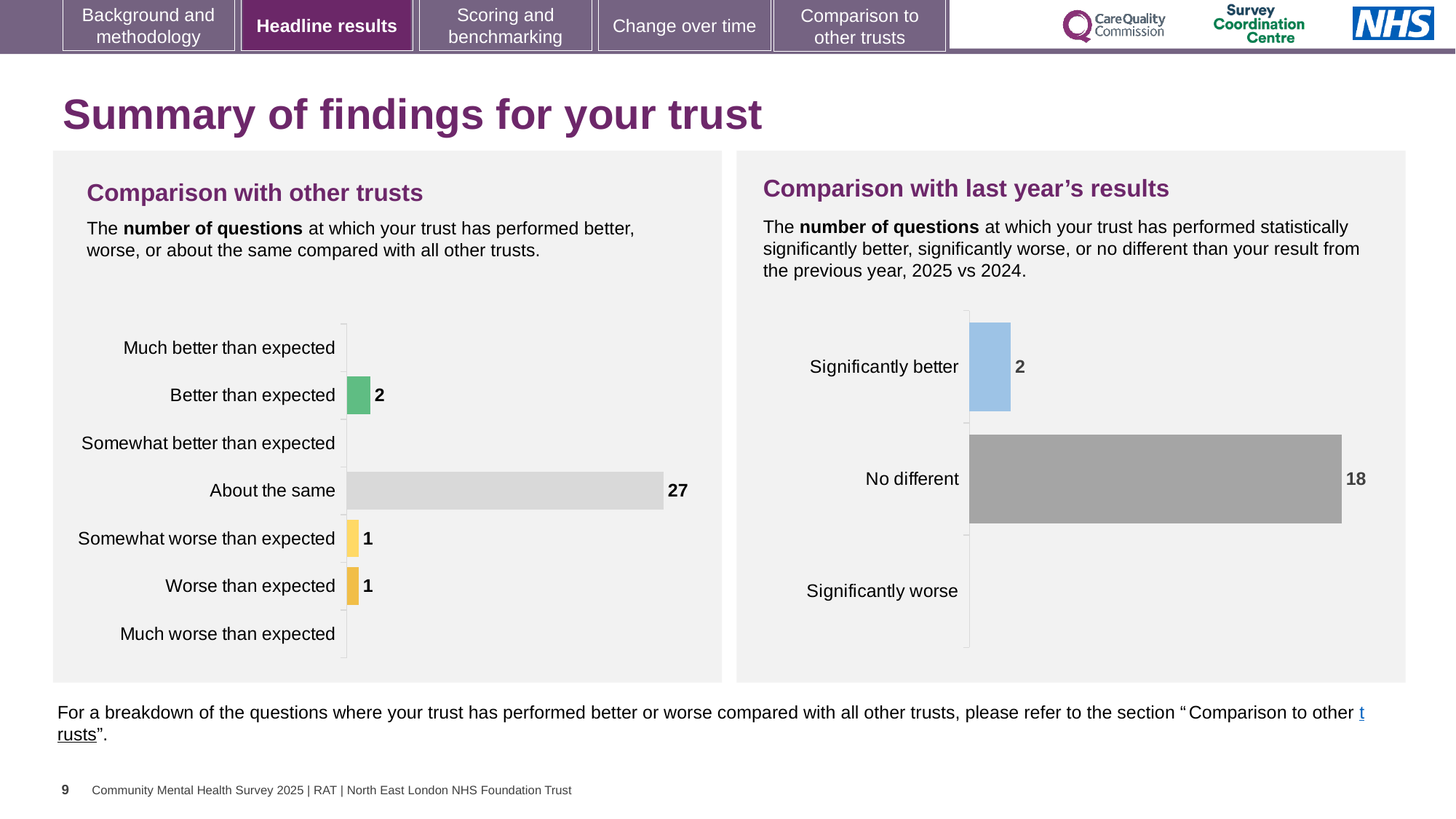
In the 'Comparison with other trusts' chart, how many questions are 'Better than expected'? 2 What type of chart is the 'Comparison with last year's results' chart? Bar chart In the 'Comparison with other trusts' chart, which category has the highest number of questions? About the same In the 'Comparison with last year's results' chart, how many questions are 'No different'? 18 In the 'Comparison with last year's results' chart, which is larger: 'Significantly better' or 'No different'? No different In the 'Comparison with other trusts' chart, what colour is the 'Better than expected' bar? Green In the 'Comparison with other trusts' chart, how many questions are 'About the same'? 27 In the 'Comparison with other trusts' chart, what is the difference between 'About the same' and 'Better than expected'? 25 In the 'Comparison with other trusts' chart, how many categories are listed on the vertical axis? 7 In the 'Comparison with last year's results' chart, how many questions are 'Significantly better'? 2 In the 'Comparison with other trusts' chart, how many questions are 'Worse than expected'? 1 In the 'Comparison with last year's results' chart, what is the difference between 'No different' and 'Significantly better'? 16